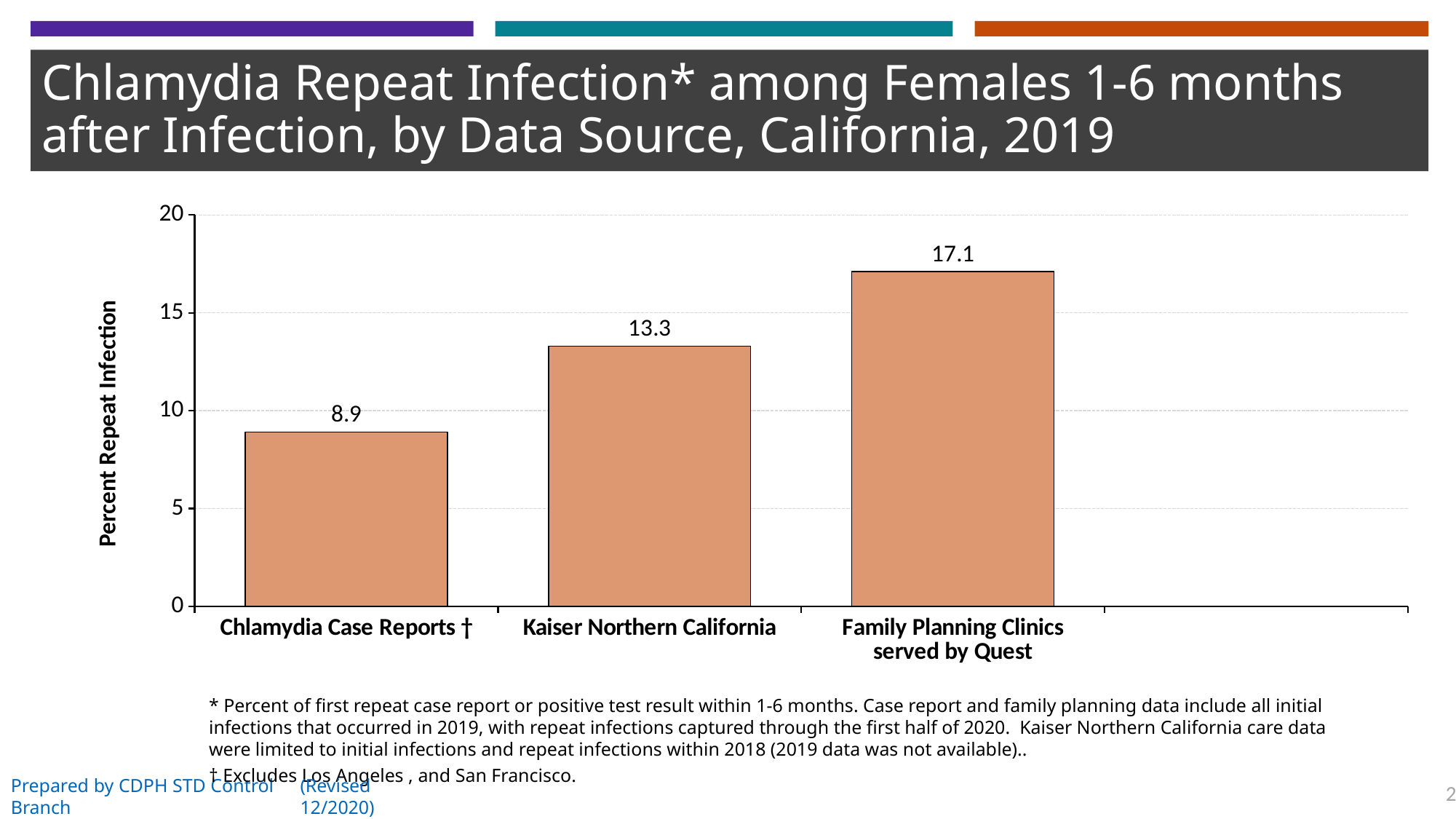
What is the percent repeat infection for Chlamydia Case Reports? 8.9 Which data source has the highest percent repeat infection? Family Planning Clinics served by Quest What kind of chart is shown on the slide? bar chart What is the label of the y axis? Percent Repeat Infection How many data sources are shown in the chart? 3 Is the value for Kaiser Northern California greater or less than 15? less What is the difference in percent repeat infection between Family Planning Clinics served by Quest and Chlamydia Case Reports? 8.2 Which data source has the lowest percent repeat infection? Chlamydia Case Reports What is the percent repeat infection for Kaiser Northern California? 13.3 Which has a higher percent repeat infection, Kaiser Northern California or Chlamydia Case Reports? Kaiser Northern California What is the percent repeat infection for Family Planning Clinics served by Quest? 17.1 What is the difference in percent repeat infection between Kaiser Northern California and Chlamydia Case Reports? 4.4